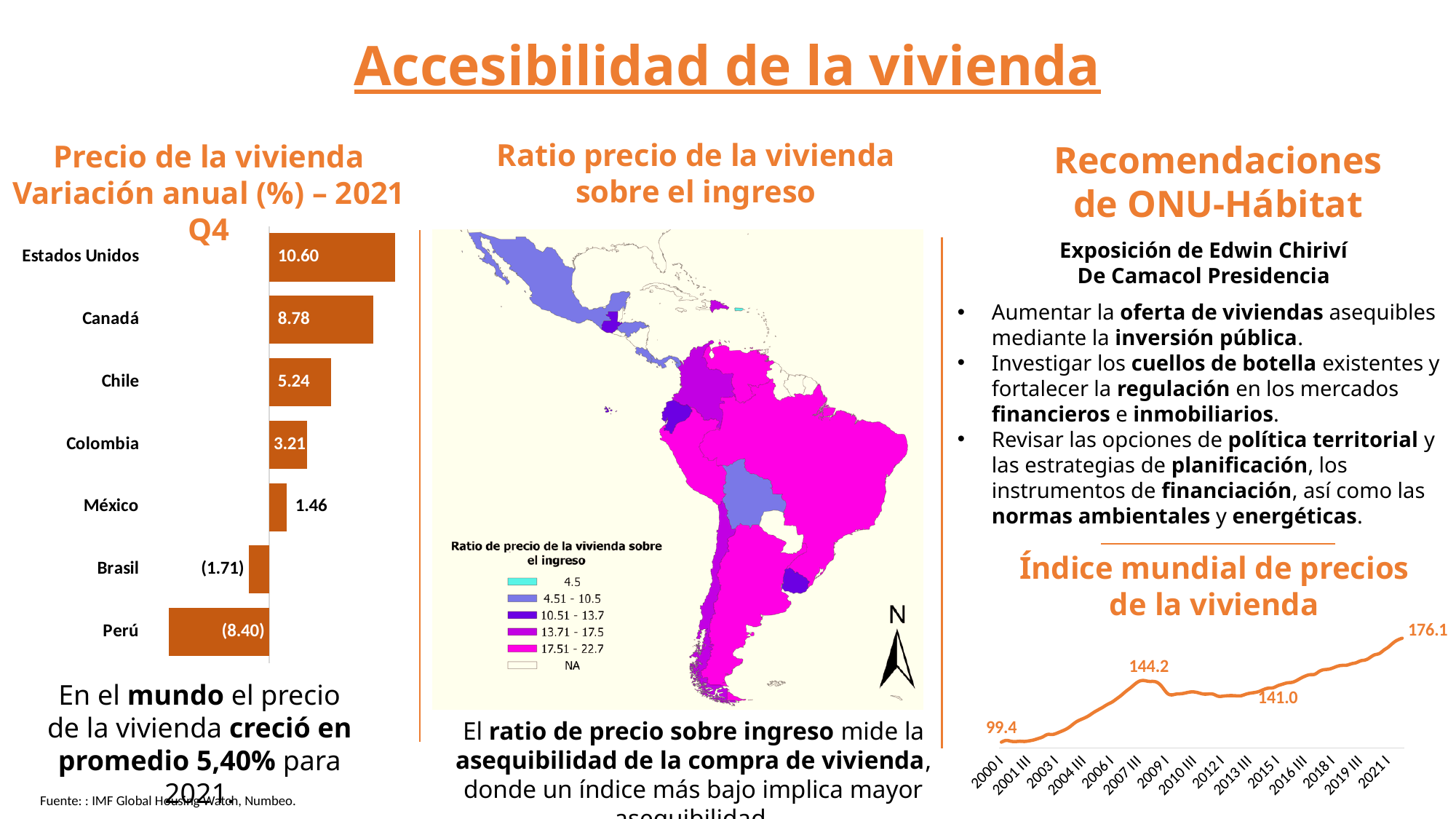
What kind of chart is 'Precio de la vivienda Variación anual (%) – 2021 Q4'? Bar chart What kind of chart is 'Índice mundial de precios de la vivienda'? Line chart In the bar chart 'Precio de la vivienda Variación anual (%) – 2021 Q4', which is larger, the value for Chile or the value for Colombia? Chile In the chart 'Índice mundial de precios de la vivienda', what is the value labelled at the start of the line (2000 I)? 99.4 In the bar chart 'Precio de la vivienda Variación anual (%) – 2021 Q4', what is the value for Estados Unidos? 10.60 In the bar chart 'Precio de la vivienda Variación anual (%) – 2021 Q4', what is the difference between the values for Estados Unidos and Canadá? 1.82 In the chart 'Índice mundial de precios de la vivienda', does the index overall rise or fall from 2000 I to 2021 I? Rise In the bar chart 'Precio de la vivienda Variación anual (%) – 2021 Q4', what is the value for Perú? (8.40) In the bar chart 'Precio de la vivienda Variación anual (%) – 2021 Q4', which country has the lowest value? Perú In the bar chart 'Precio de la vivienda Variación anual (%) – 2021 Q4', which country has the highest value? Estados Unidos How many countries are shown in the bar chart 'Precio de la vivienda Variación anual (%) – 2021 Q4'? 7 In the chart 'Índice mundial de precios de la vivienda', what is the value labelled at the end of the line (2021 I)? 176.1